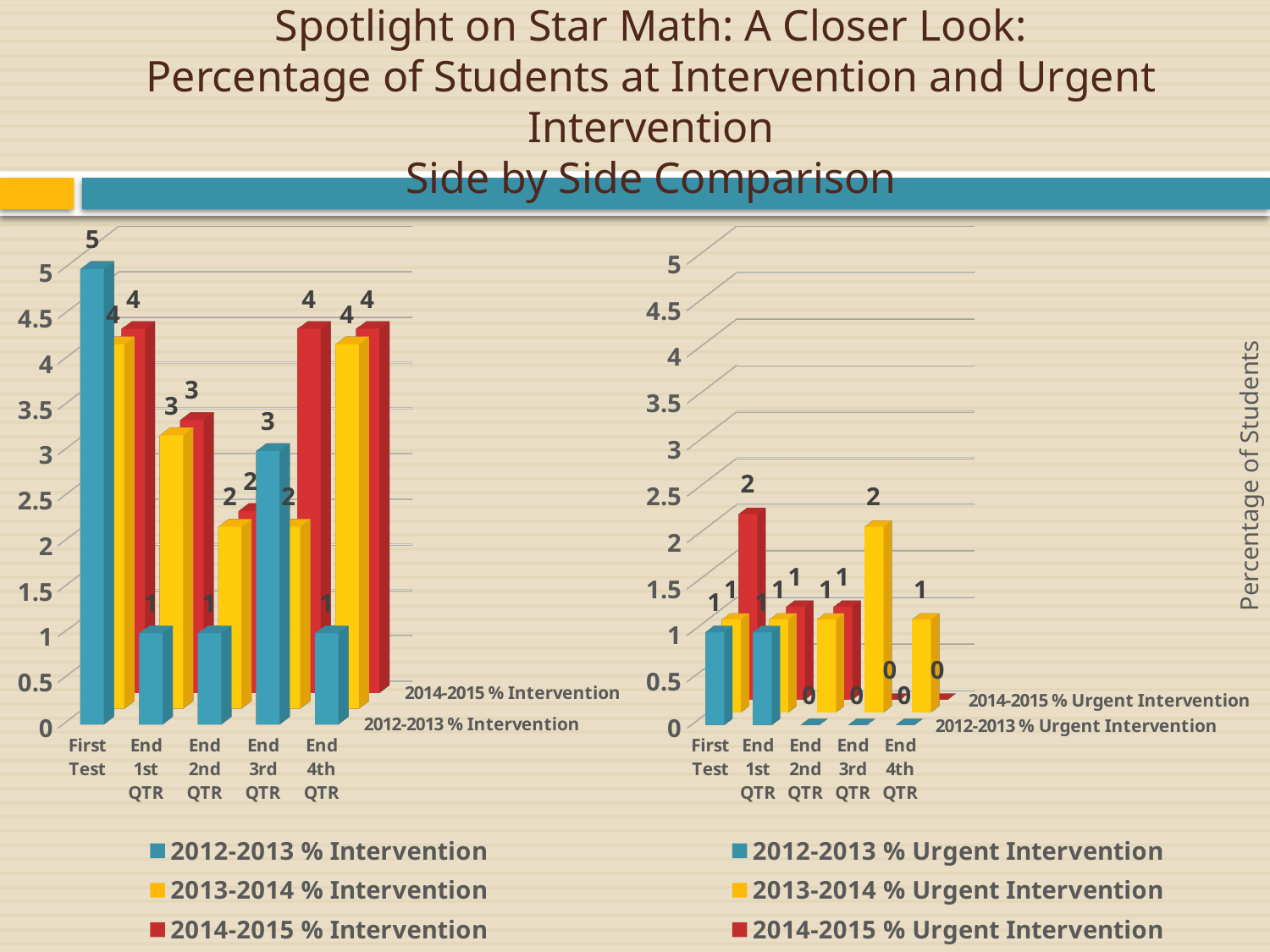
In the left chart (% Intervention), what is the difference between the 2012-2013 and 2013-2014 values at First Test? 1 In the right chart (% Urgent Intervention), what is the value for 2013-2014 % Urgent Intervention at End 3rd QTR? 2 In the left chart (% Intervention), what is the value for 2013-2014 % Intervention at End 1st QTR? 3 In the left chart (% Intervention), what is the value for 2014-2015 % Intervention at End 3rd QTR? 4 In the left chart (% Intervention), which category has the highest value for 2012-2013 % Intervention? First Test In the left chart (% Intervention), at End 4th QTR, which is larger: 2012-2013 % Intervention or 2013-2014 % Intervention? 2013-2014 % Intervention In the right chart (% Urgent Intervention), what is the value for 2014-2015 % Urgent Intervention at First Test? 2 What kind of chart is the right chart (% Urgent Intervention)? bar chart How many series does the legend of the right chart (% Urgent Intervention) list? 3 In the left chart (% Intervention), what is the value for 2012-2013 % Intervention at First Test? 5 How many categories are shown on the x axis of the left chart (% Intervention)? 5 What is the label on the vertical axis at the right edge of the slide? Percentage of Students